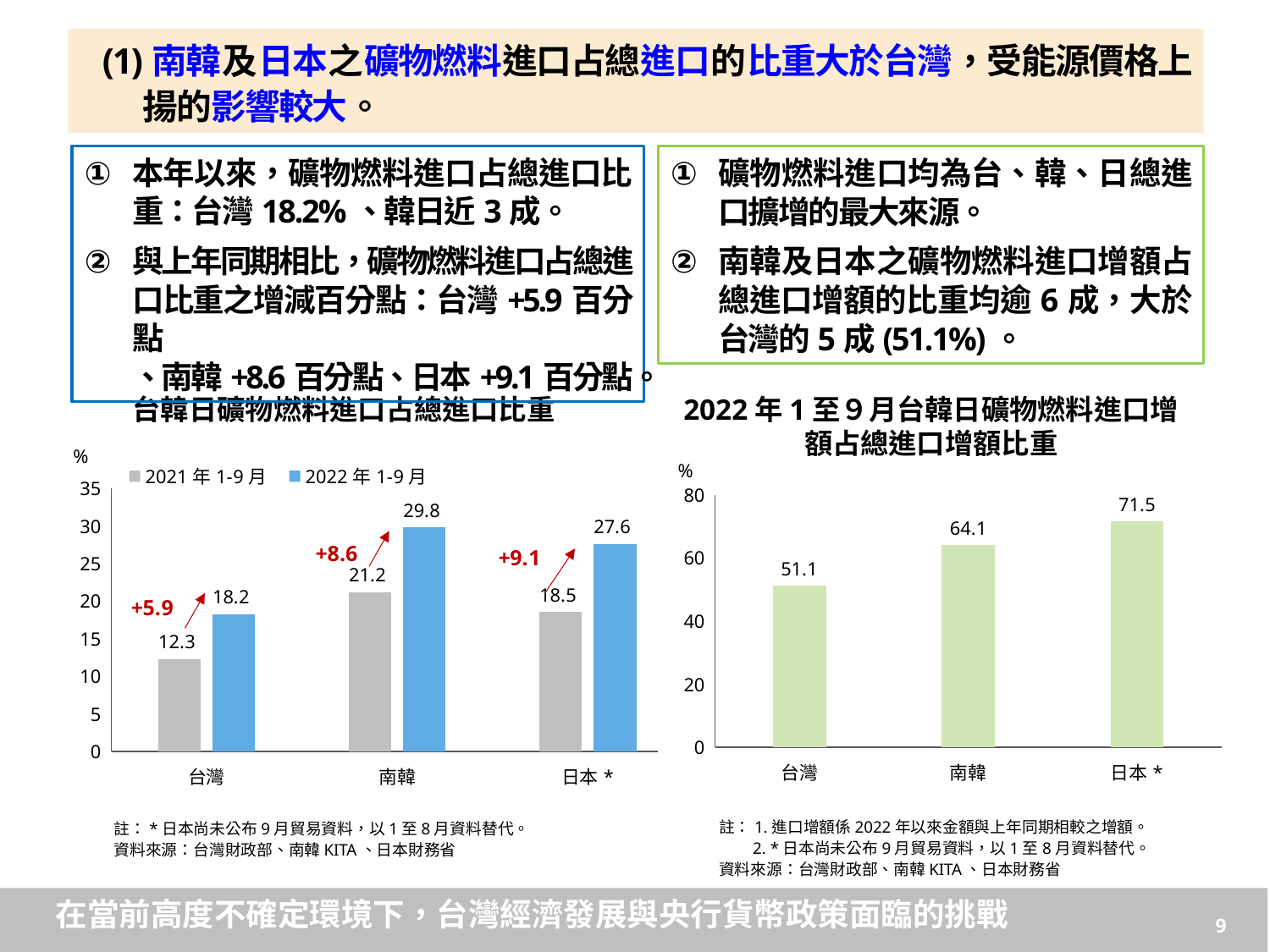
In the left chart (台韓日礦物燃料進口占總進口比重), what is the value for 南韓 in 2021年1-9月? 21.2 In the right chart (2022年1至9月台韓日礦物燃料進口增額占總進口增額比重), how many categories are shown? 3 What type of chart is the right chart (2022年1至9月台韓日礦物燃料進口增額占總進口增額比重)? Bar chart In the left chart (台韓日礦物燃料進口占總進口比重), which is larger: 南韓 in 2021年1-9月 or 日本* in 2021年1-9月? 南韓 In the right chart (2022年1至9月台韓日礦物燃料進口增額占總進口增額比重), what is the value for 南韓? 64.1 In the left chart (台韓日礦物燃料進口占總進口比重), how many series does the legend list? 2 In the left chart (台韓日礦物燃料進口占總進口比重), what is the difference between the 2022年1-9月 and 2021年1-9月 values for 日本*? 9.1 In the left chart (台韓日礦物燃料進口占總進口比重), what is the value for 台灣 in 2022年1-9月? 18.2 In the right chart (2022年1至9月台韓日礦物燃料進口增額占總進口增額比重), which category has the highest value? 日本* In the left chart (台韓日礦物燃料進口占總進口比重), which category has the lowest value in 2021年1-9月? 台灣 In the left chart (台韓日礦物燃料進口占總進口比重), which category has the highest value in 2022年1-9月? 南韓 In the right chart (2022年1至9月台韓日礦物燃料進口增額占總進口增額比重), what is the difference between 日本* and 台灣? 20.4